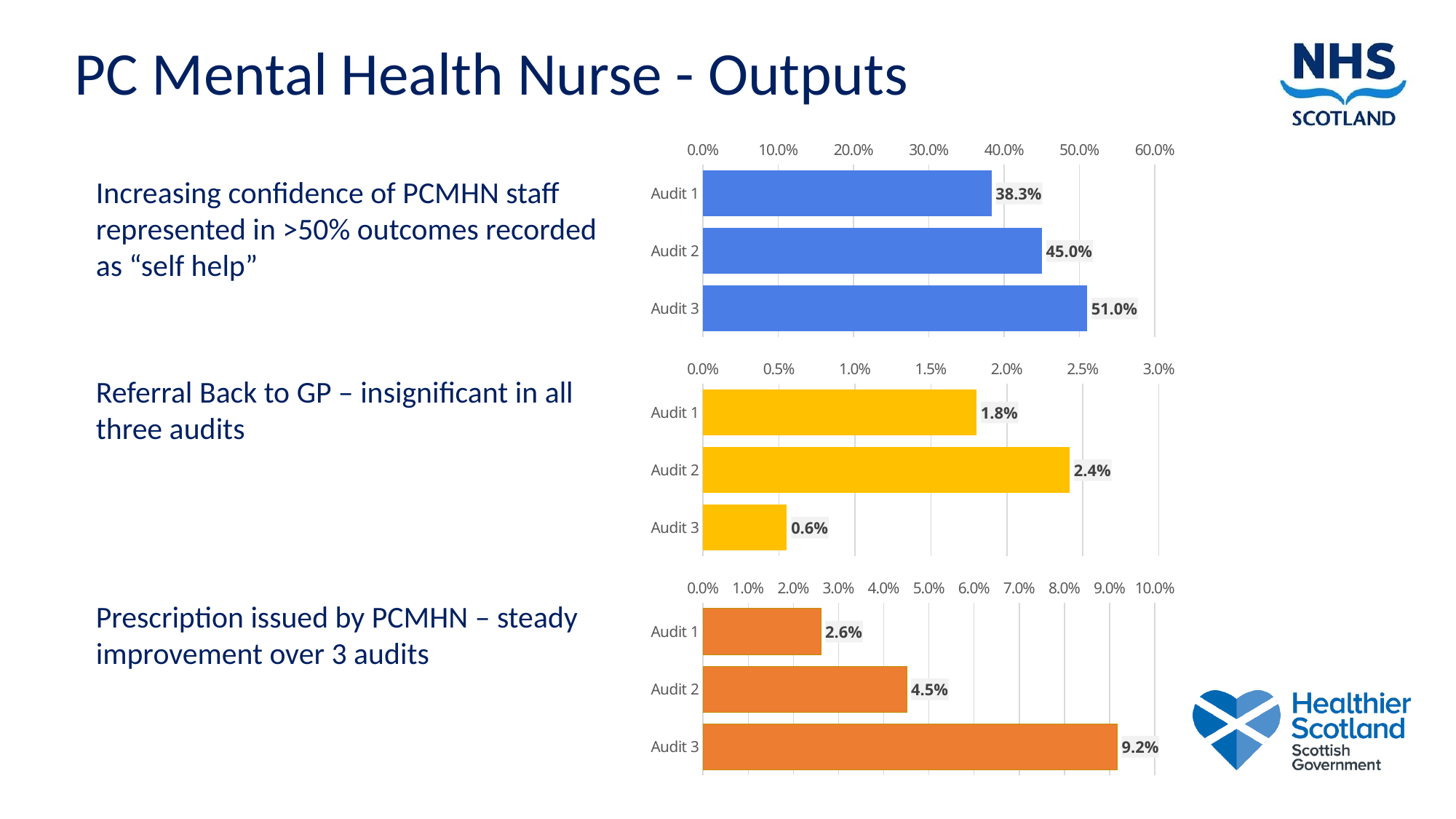
In the bottom chart (orange bars), which is larger, Audit 1 or Audit 2? Audit 2 In the middle chart (yellow bars), what is the value for Audit 2? 2.4% In the bottom chart (orange bars), what is the value for Audit 3? 9.2% In the top chart (blue bars), what is the value for Audit 1? 38.3% In the bottom chart (orange bars), what is the difference between Audit 3 and Audit 2? 4.7% What type of chart is the middle chart (yellow bars)? bar chart In the top chart (blue bars), what is the difference between Audit 3 and Audit 1? 12.7% In the top chart (blue bars), do the values rise or fall from Audit 1 to Audit 3? rise In the middle chart (yellow bars), is the value for Audit 1 greater or less than 2.0%? less In the middle chart (yellow bars), which audit has the lowest value? Audit 3 How many bars does the bottom chart (orange bars) have? 3 In the top chart (blue bars), which audit has the highest value? Audit 3